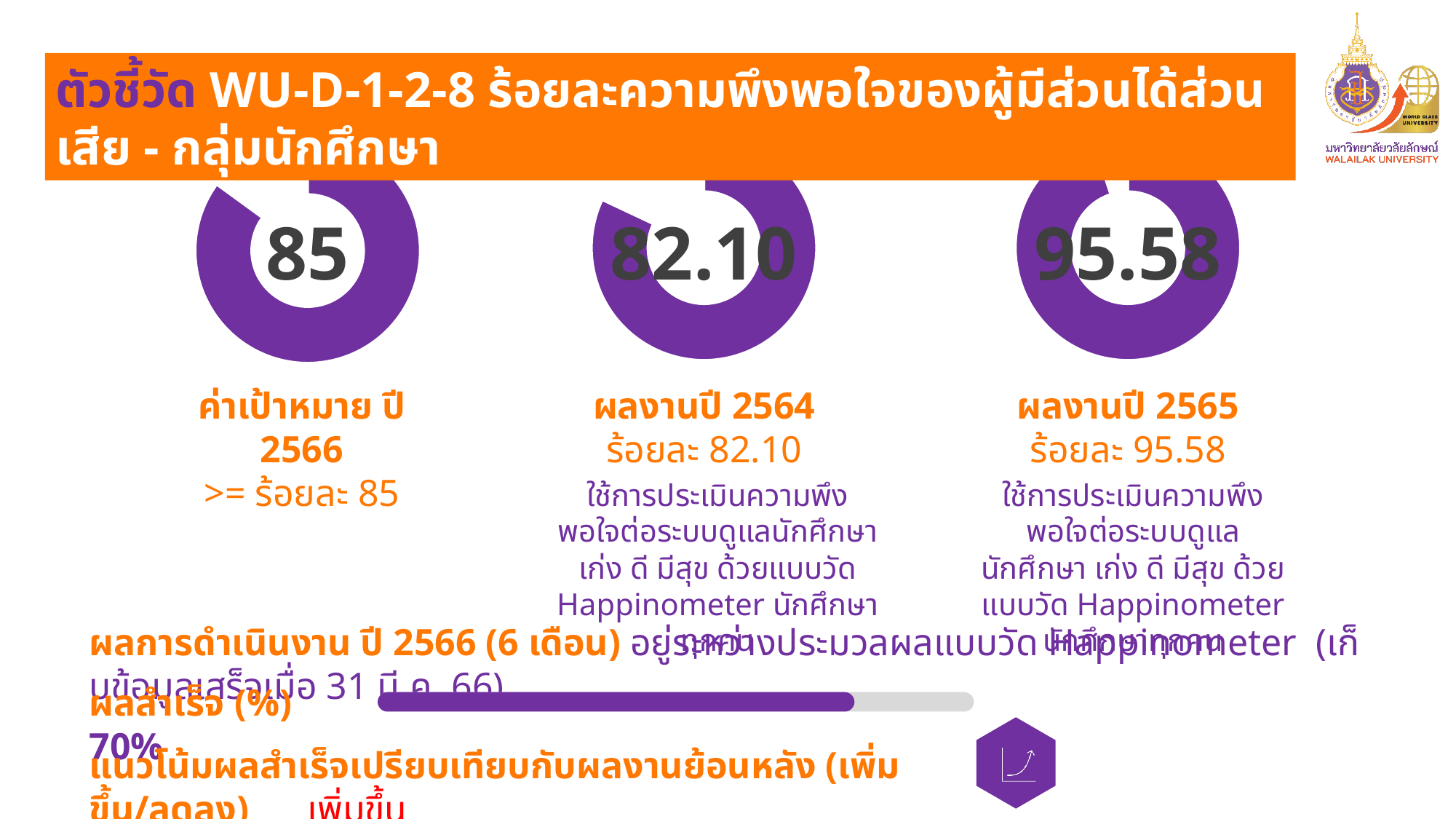
Which of the three doughnut charts shows the highest value? ผลงานปี 2565 What value is shown in the centre of the right doughnut chart labelled ผลงานปี 2565? 95.58 What kind of chart is used to display the values 85, 82.10 and 95.58? doughnut chart What value is shown in the centre of the left doughnut chart labelled ค่าเป้าหมาย ปี 2566? 85 What colour is the filled ring of the doughnut charts? purple What is the difference between the value in the ผลงานปี 2565 doughnut chart and the value in the ผลงานปี 2564 doughnut chart? 13.48 Which is larger: the value in the ผลงานปี 2564 doughnut chart or the value in the ค่าเป้าหมาย ปี 2566 doughnut chart? ค่าเป้าหมาย ปี 2566 Which of the three doughnut charts shows the lowest value? ผลงานปี 2564 What value is shown in the centre of the middle doughnut chart labelled ผลงานปี 2564? 82.10 Did the value rise or fall from the ผลงานปี 2564 doughnut chart to the ผลงานปี 2565 doughnut chart? rise What is the difference between the value in the ผลงานปี 2565 doughnut chart and the target value in the ค่าเป้าหมาย ปี 2566 doughnut chart? 10.58 How many doughnut charts are shown on the slide? 3